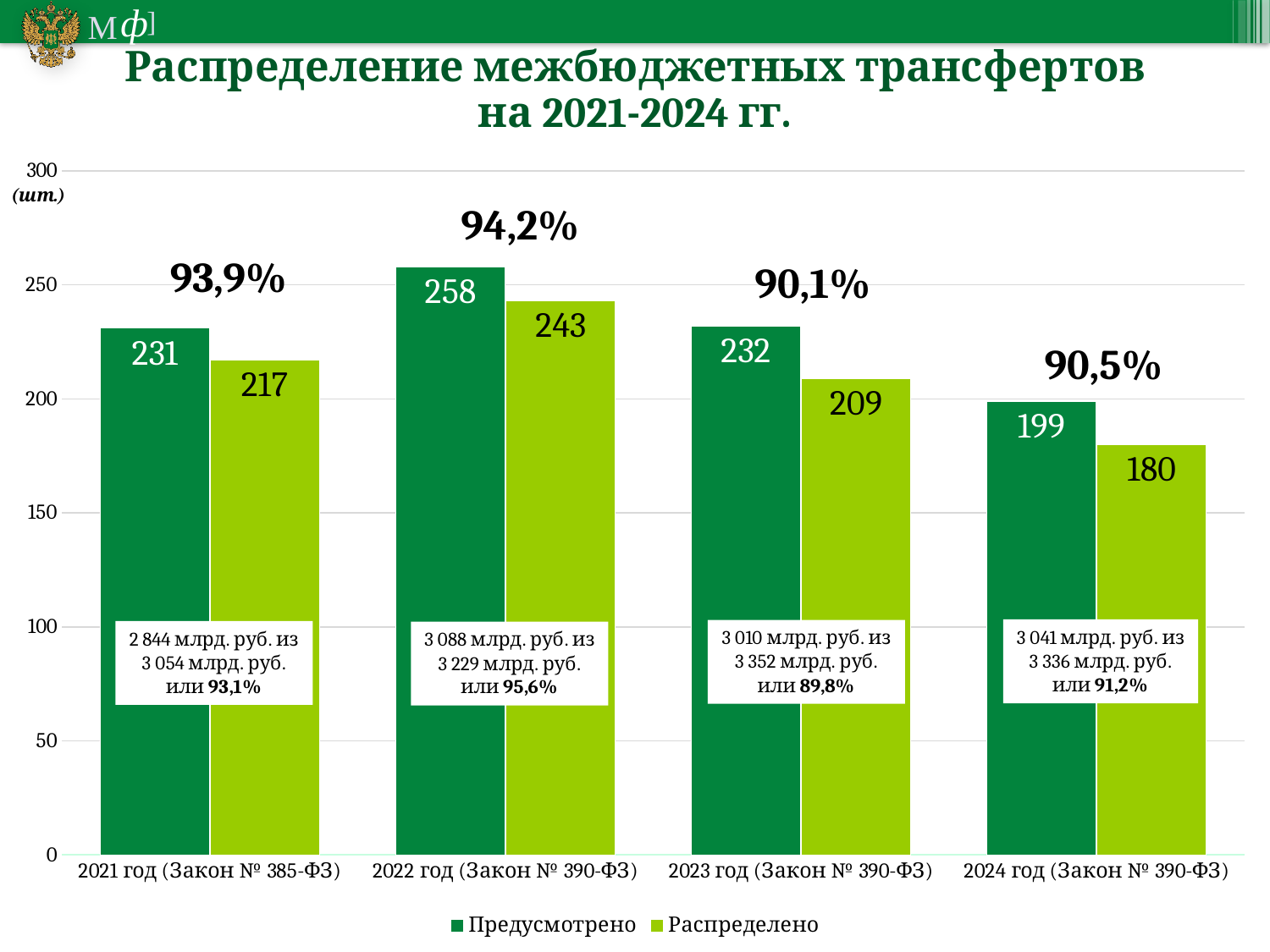
How many series does the legend list? 2 How many year categories are shown on the x axis? 4 What percentage is shown above the bars for 2022 год (Закон № 390-ФЗ)? 94,2% Which year has the lowest Распределено value? 2024 год (Закон № 390-ФЗ) Which is larger: Распределено for 2021 год or Распределено for 2023 год? 2021 год (217) What kind of chart is shown on the slide? Bar chart What is the title of the chart? Распределение межбюджетных трансфертов на 2021-2024 гг. What is the value of Распределено for 2024 год (Закон № 390-ФЗ)? 180 What is the value of Предусмотрено for 2021 год (Закон № 385-ФЗ)? 231 What is the value of Распределено for 2022 год (Закон № 390-ФЗ)? 243 What is the difference between Предусмотрено and Распределено for 2023 год (Закон № 390-ФЗ)? 23 Which year has the highest Предусмотрено value? 2022 год (Закон № 390-ФЗ)